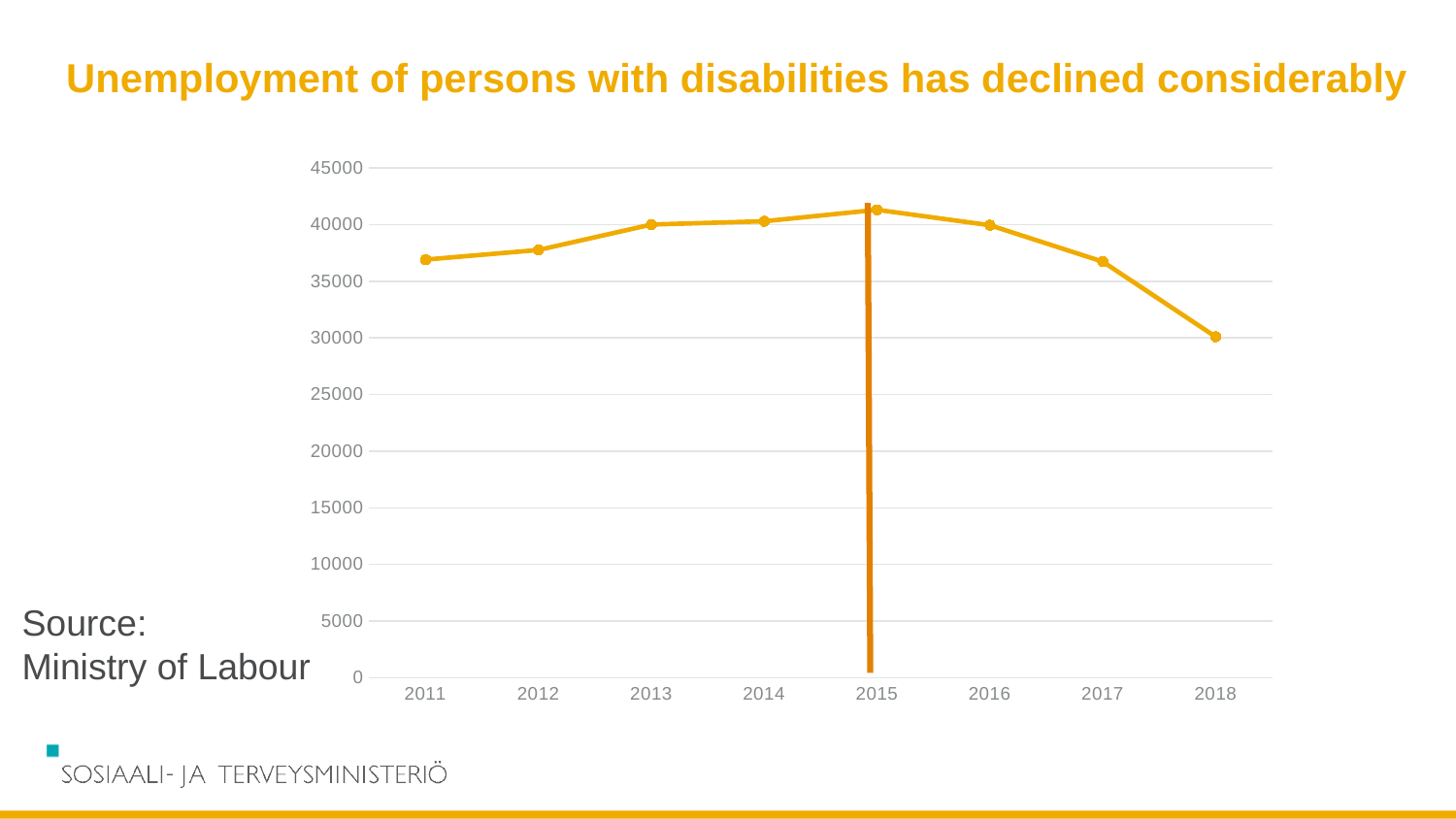
What is the title of the slide above the chart? Unemployment of persons with disabilities has declined considerably Which is larger, the value for 2011 or the value for 2018? 2011 Which year has the lowest value on the chart? 2018 Do the values rise or fall between 2015 and 2018? fall How many years are plotted on the x axis of the chart? 8 What kind of chart is shown on the slide? line chart Which year has the highest value on the chart? 2015 Which is larger, the value for 2013 or the value for 2017? 2013 Is the value for 2018 greater or less than 35000? less Is the value for 2012 greater or less than 40000? less Is the value for 2015 greater or less than 40000? greater